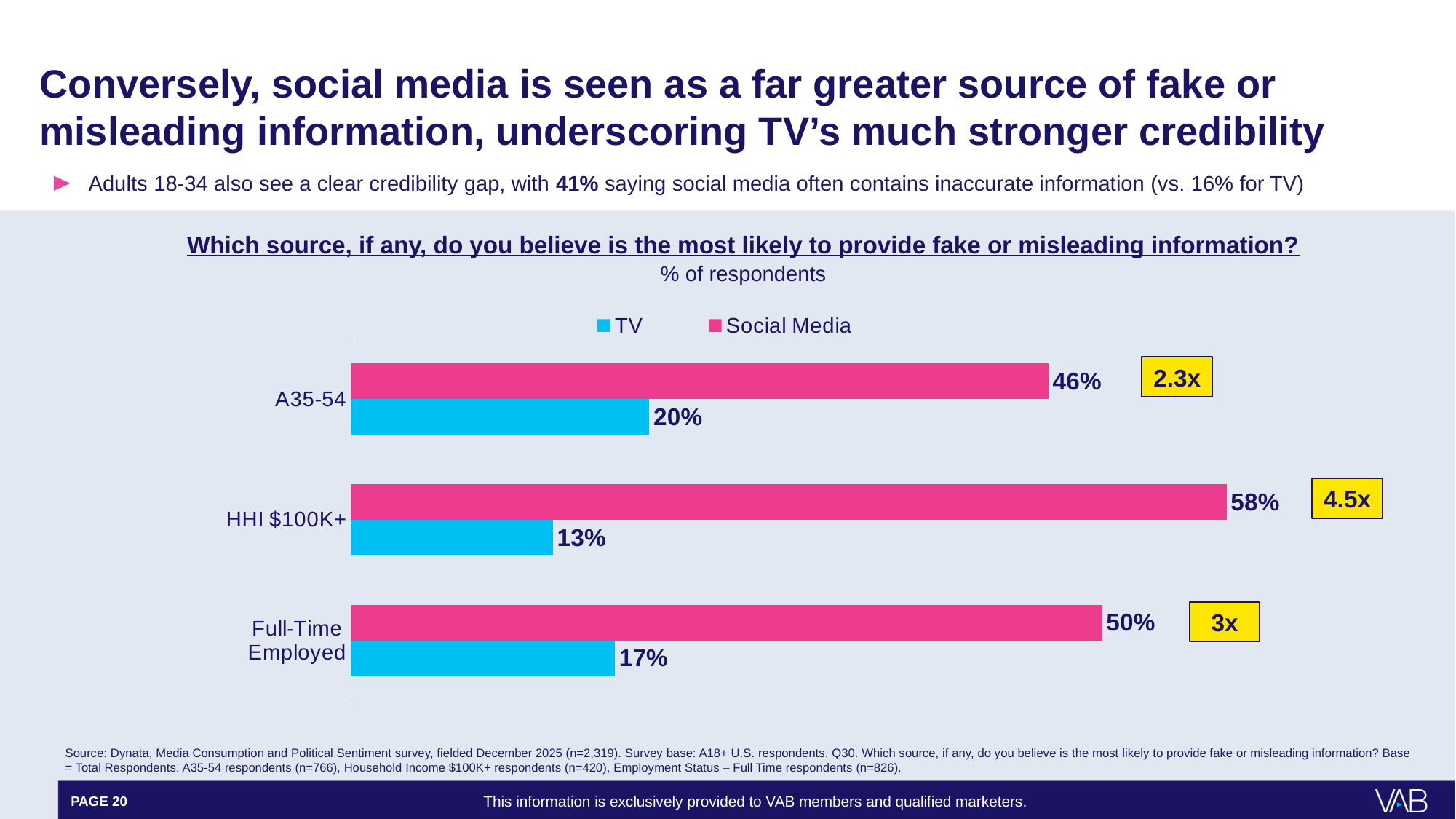
Which is larger for Full-Time Employed respondents, the TV value or the Social Media value? Social Media What percentage of A35-54 respondents said Social Media is the most likely source of fake or misleading information? 46% Which category has the lowest TV value? HHI $100K+ What multiplier is shown in the yellow box next to the HHI $100K+ bars? 4.5x Which category has the highest Social Media value? HHI $100K+ What is the Social Media value for Full-Time Employed respondents? 50% What is the difference between the Social Media and TV values for HHI $100K+? 45 percentage points What kind of chart is shown on the slide? Bar chart What is the difference between the Social Media and TV values for A35-54? 26 percentage points What is the TV value for HHI $100K+ respondents? 13% How many categories are shown on the chart? 3 How many series does the legend list? 2